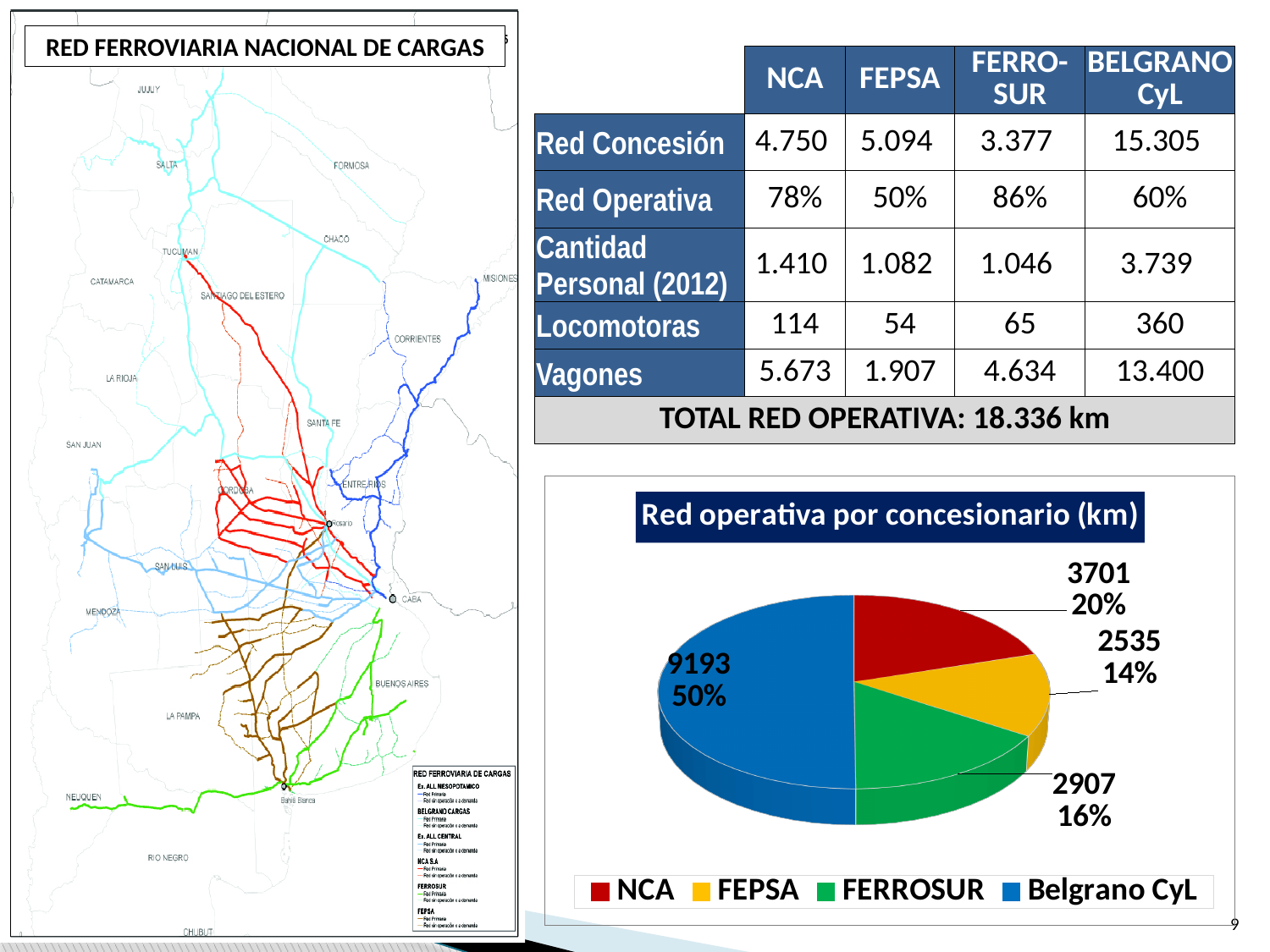
How many slices does the pie chart 'Red operativa por concesionario (km)' have? 4 In the pie chart 'Red operativa por concesionario (km)', what share of the pie does FERROSUR have? 16% In the pie chart 'Red operativa por concesionario (km)', which concessionaire has the smallest slice? FEPSA In the pie chart 'Red operativa por concesionario (km)', what is the value for FERROSUR? 2907 In the pie chart 'Red operativa por concesionario (km)', which is larger, the value for FERROSUR or the value for FEPSA? FERROSUR In the pie chart 'Red operativa por concesionario (km)', which concessionaire has the largest slice? Belgrano CyL In the pie chart 'Red operativa por concesionario (km)', what is the value for NCA? 3701 In the pie chart 'Red operativa por concesionario (km)', what is the value for Belgrano CyL? 9193 What kind of chart is 'Red operativa por concesionario (km)'? pie chart In the pie chart 'Red operativa por concesionario (km)', what is the value for FEPSA? 2535 In the pie chart 'Red operativa por concesionario (km)', what is the difference between the values for Belgrano CyL and NCA? 5492 In the pie chart 'Red operativa por concesionario (km)', what share of the pie does Belgrano CyL have? 50%